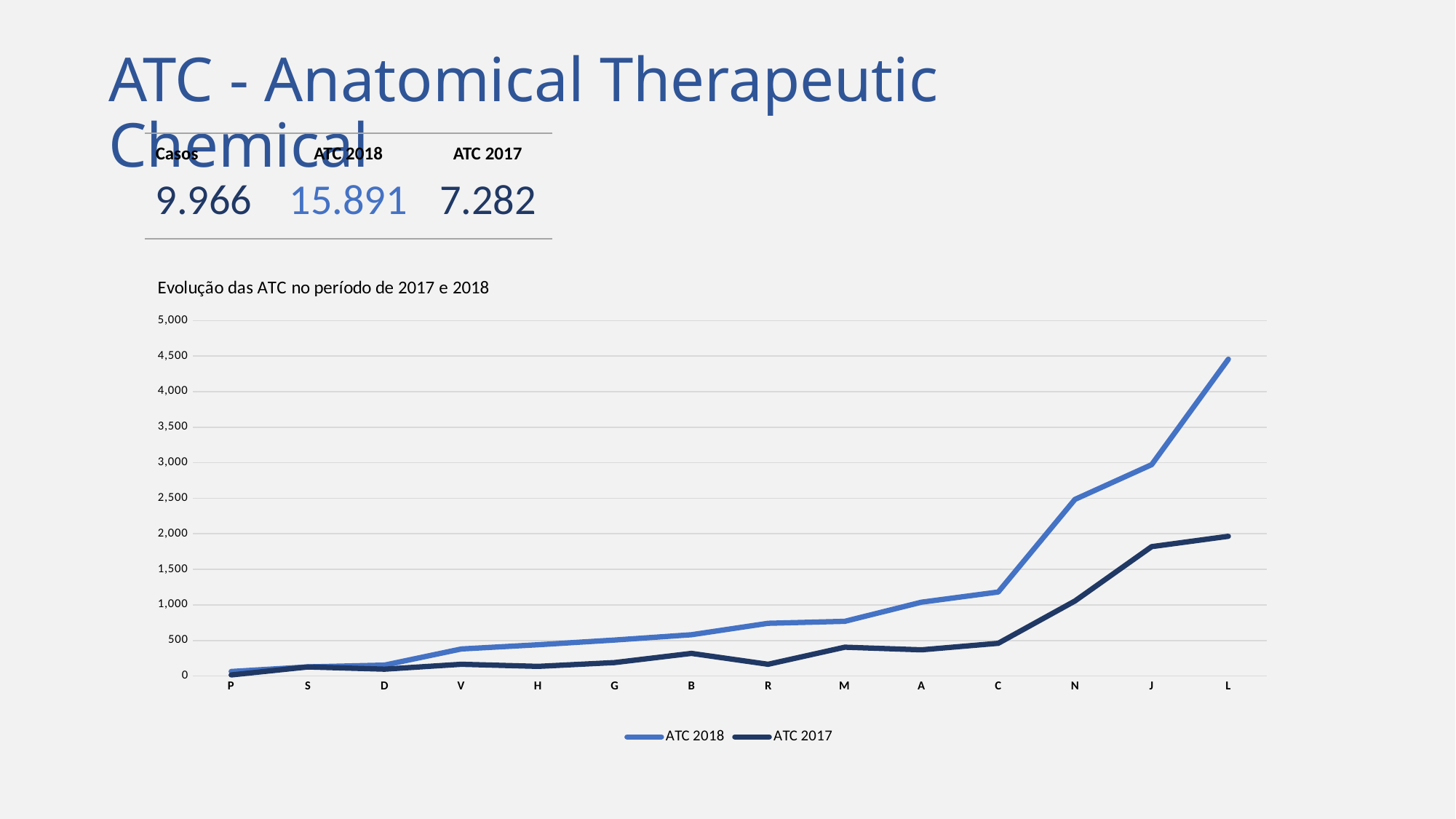
Do the values for ATC 2018 generally rise or fall from P to L along the x axis? rise Which category has the highest value for ATC 2018? L How many categories are shown along the x axis of the chart? 14 What is the title of the chart? Evolução das ATC no período de 2017 e 2018 Is the value for ATC 2018 at category L greater or less than 4,000? greater Which series is drawn with the darker navy line? ATC 2017 How many series does the chart legend list? 2 Is the value for ATC 2017 at category J greater or less than 1,500? greater Which category has the lowest value for ATC 2018? P Is the value for ATC 2018 at category N greater or less than 2,000? greater What kind of chart is shown on the slide? line chart At category L, which series has the larger value, ATC 2018 or ATC 2017? ATC 2018